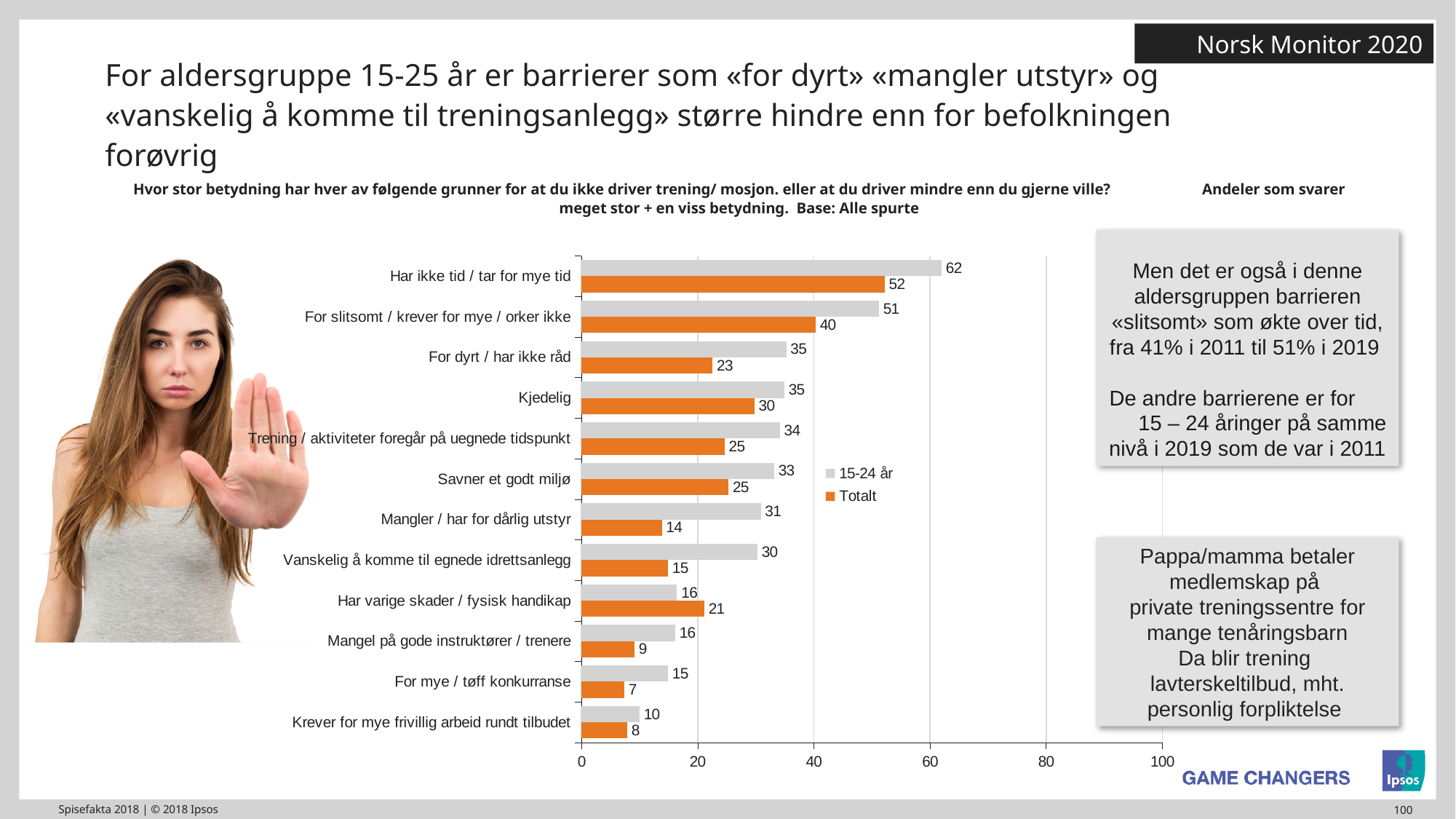
Which category has the lowest "Totalt" value? For mye / tøff konkurranse For "Har varige skader / fysisk handikap", which series has the larger value, "15-24 år" or "Totalt"? Totalt What is the "Totalt" value for "For dyrt / har ikke råd"? 23 Which colour represents the "Totalt" series in the chart? Orange How many categories are shown in the chart? 12 What is the difference between the "15-24 år" and "Totalt" values for "Mangler / har for dårlig utstyr"? 17 Which category has the highest "Totalt" value? Har ikke tid / tar for mye tid What is the value for "15-24 år" for "Har ikke tid / tar for mye tid"? 62 Is the "15-24 år" value for "For slitsomt / krever for mye / orker ikke" greater or less than 40? greater How many series does the legend list? 2 What is the "Totalt" value for "Mangler / har for dårlig utstyr"? 14 What type of chart is shown on the slide? Bar chart